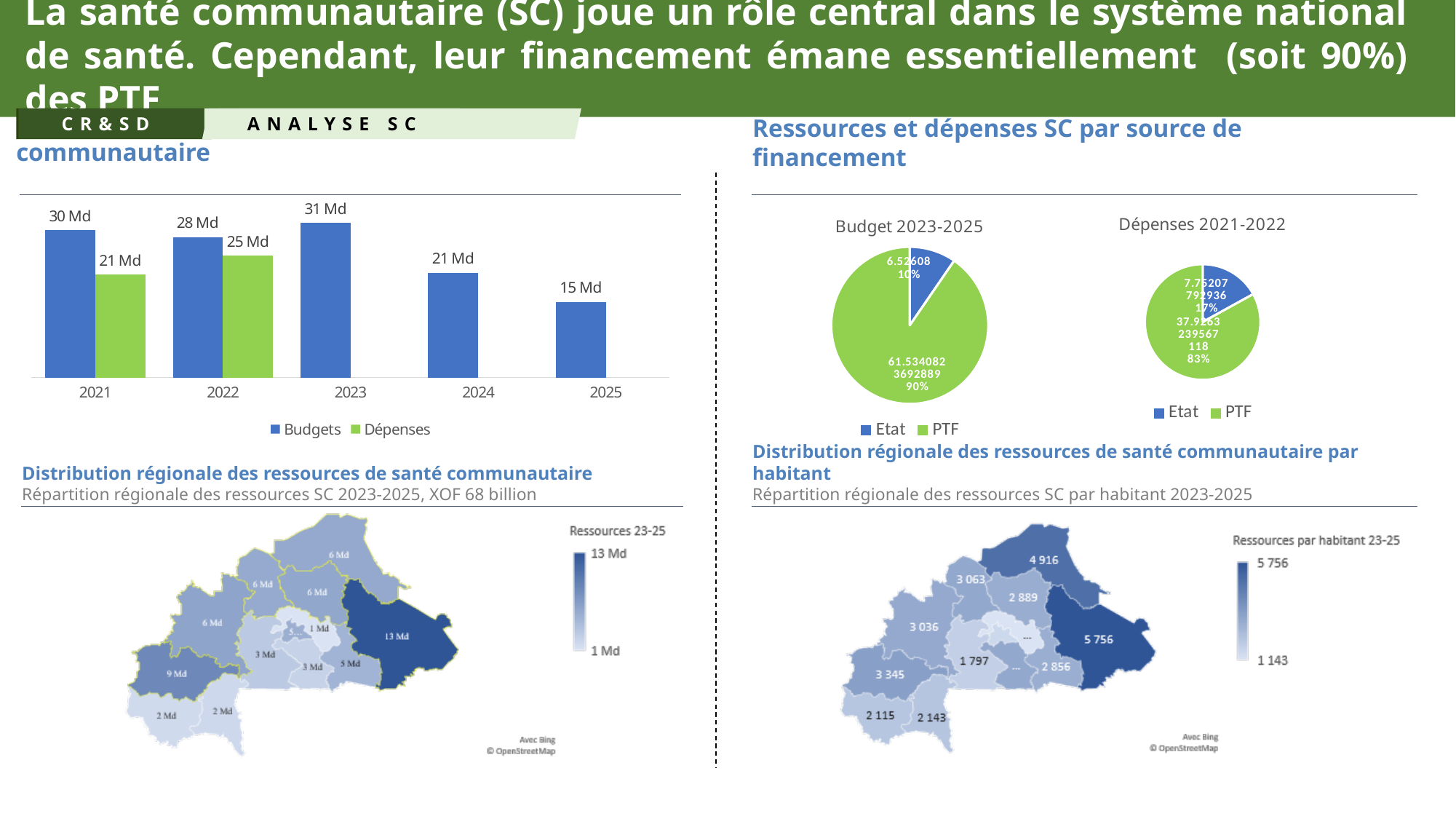
In the bar chart on the top left, which year has the highest Budgets value? 2023 In the bar chart on the top left, what is the Dépenses value for 2022? 25 Md In the map titled 'Distribution régionale des ressources de santé communautaire', what is the highest regional value shown? 13 Md In the pie chart titled 'Dépenses 2021-2022', what share does Etat represent? 17% What kind of chart is the chart on the top left showing Budgets and Dépenses by year? Bar chart In the map titled 'Distribution régionale des ressources de santé communautaire par habitant', what is the highest regional value shown? 5 756 In the bar chart on the top left, what is the Budgets value for 2023? 31 Md In the bar chart on the top left, what is the difference between Budgets and Dépenses in 2021? 9 Md How many series does the legend of the bar chart on the top left list? 2 In the pie chart titled 'Budget 2023-2025', what share does PTF represent? 90% In the bar chart on the top left, which year has the lowest Budgets value? 2025 In the bar chart on the top left, which is larger in 2022: Budgets or Dépenses? Budgets